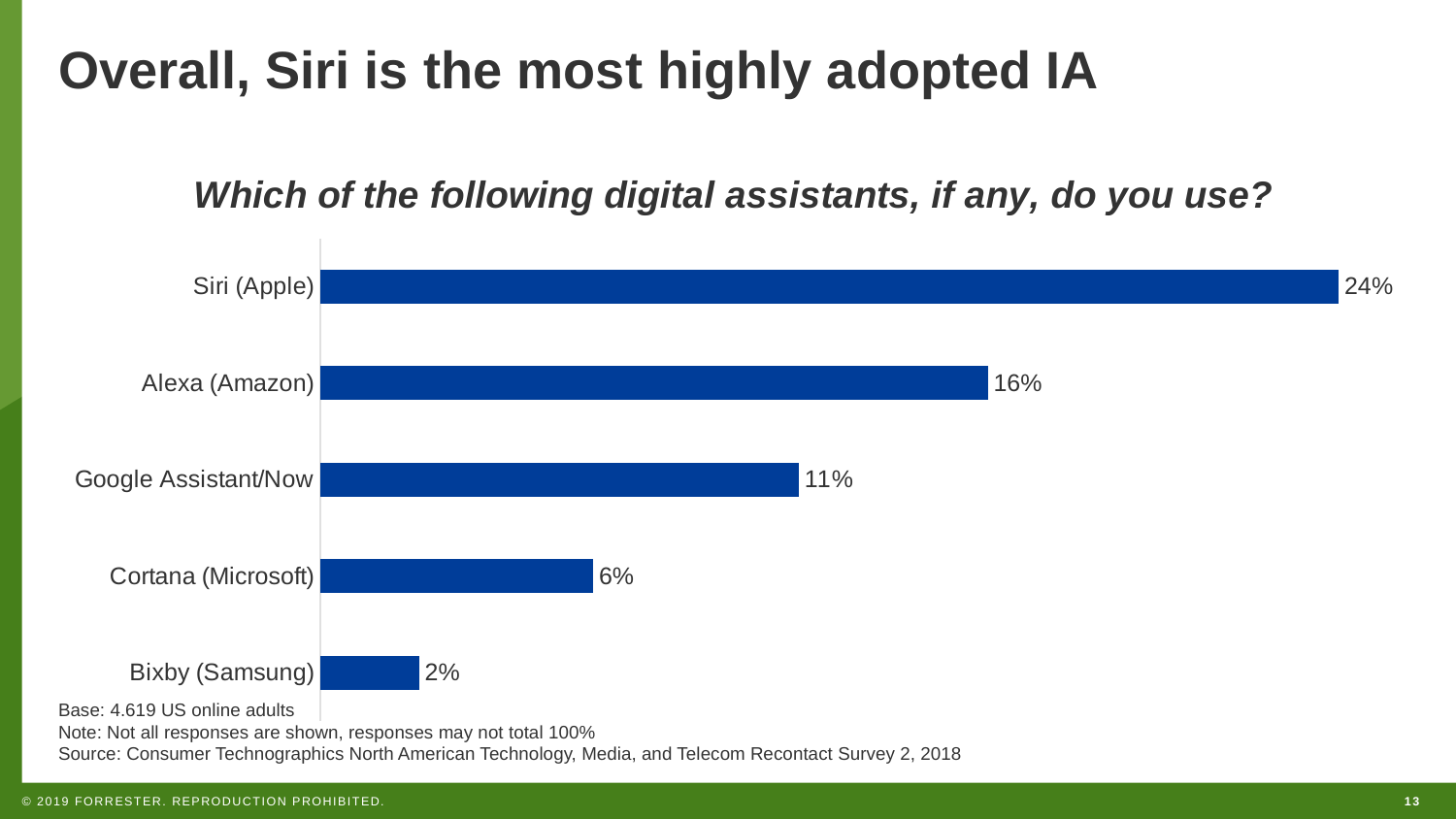
Which digital assistant has the highest share of users? Siri (Apple) What question does the chart title ask? Which of the following digital assistants, if any, do you use? Which digital assistant has the lowest share of users? Bixby (Samsung) What is the difference in percentage points between Siri (Apple) and Alexa (Amazon)? 8 percentage points What percentage of respondents use Siri (Apple)? 24% What percentage of respondents use Alexa (Amazon)? 16% How many digital assistants are shown in the chart? 5 What type of chart is shown on the slide? Bar chart Which has a higher share of users, Google Assistant/Now or Cortana (Microsoft)? Google Assistant/Now What percentage of respondents use Cortana (Microsoft)? 6% What percentage of respondents use Google Assistant/Now? 11% What percentage of respondents use Bixby (Samsung)? 2%